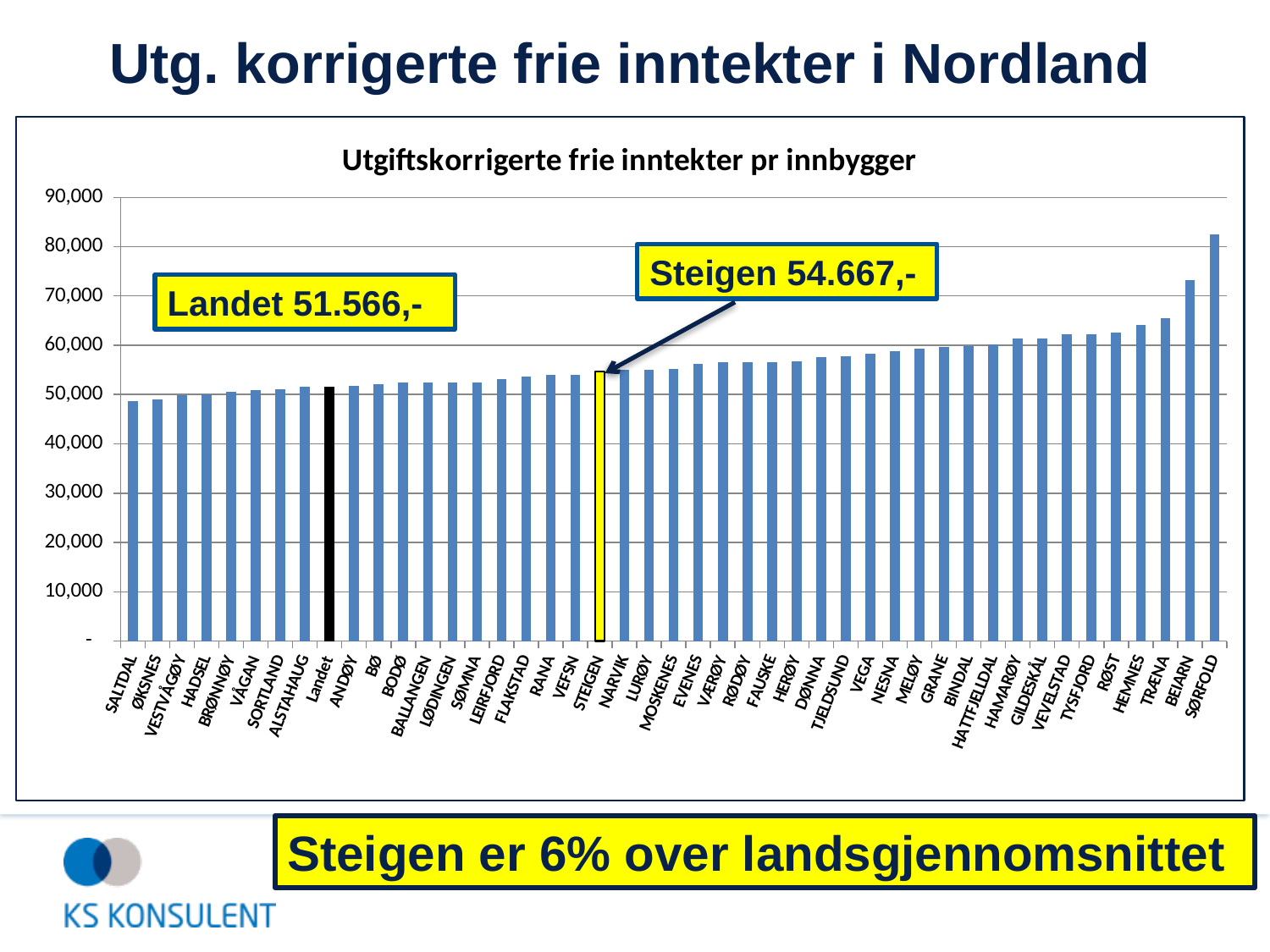
Which category has the highest value? SØRFOLD Is the value for BEIARN greater or less than 70,000? greater What type of chart is shown on the slide? bar chart Which category has the lowest value? SALTDAL What is the value for Landet? 51.566,- What is the difference between the value for Steigen and the value for Landet? 3.101,- Is the value for SØRFOLD greater or less than 80,000? greater What is the title of the chart? Utgiftskorrigerte frie inntekter pr innbygger Which is larger, the value for BEIARN or the value for TRÆNA? BEIARN What is the value for Steigen? 54.667,- Is the value for SALTDAL greater or less than 50,000? less Do the values rise or fall from left to right along the x axis? rise